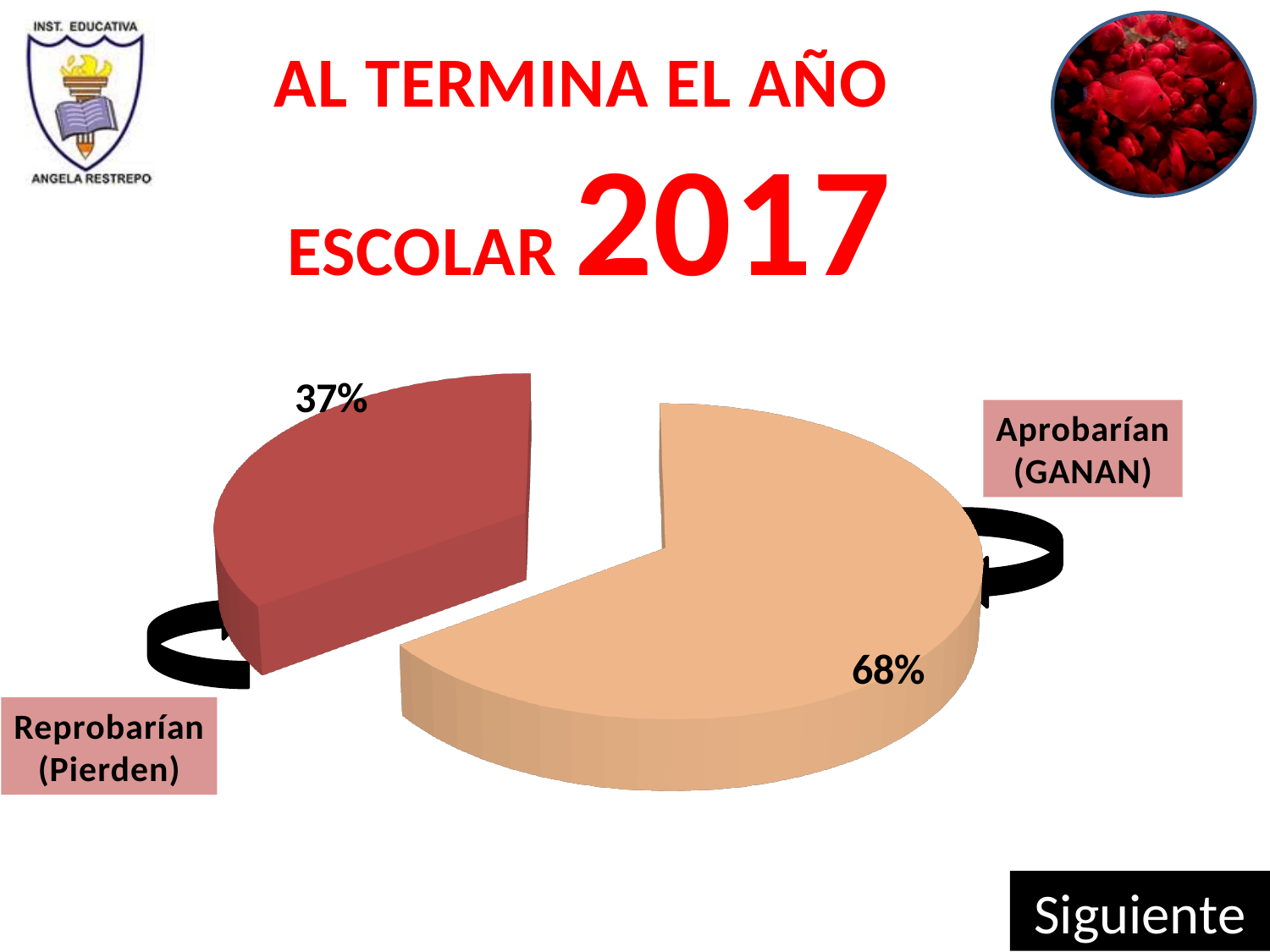
What is the title shown above the pie chart? AL TERMINA EL AÑO ESCOLAR 2017 Which category has the largest slice of the pie chart? Aprobarían (GANAN) What percentage of students would fail (Reprobarían / Pierden) according to the pie chart? 37% Which is larger, the Aprobarían (GANAN) slice or the Reprobarían (Pierden) slice? Aprobarían (GANAN) What percentage of students would pass (Aprobarían / GANAN) according to the pie chart? 68% How many slices does the pie chart have? 2 What colour is the Reprobarían (Pierden) slice of the pie chart? Red Which category has the smallest slice of the pie chart? Reprobarían (Pierden) What type of chart is shown on the slide? Pie chart What is the difference in percentage points between the Aprobarían (GANAN) slice and the Reprobarían (Pierden) slice? 31 What share of the pie does the Reprobarían (Pierden) slice represent? 37%